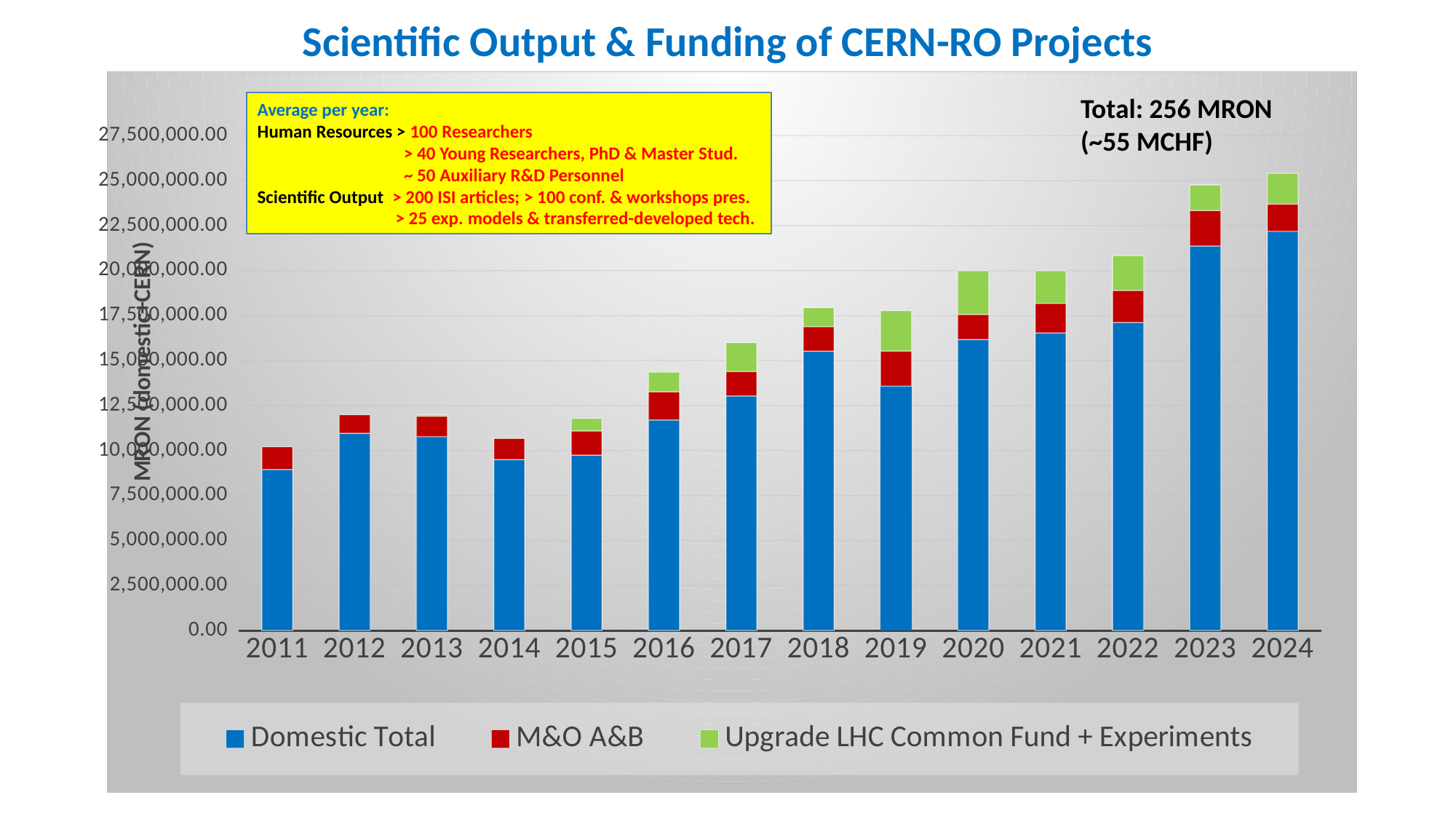
How many series does the chart legend list? 3 Which year has the tallest stacked bar overall? 2024 Is the Domestic Total value for 2011 greater or less than 10,000,000.00? less In which year does the Upgrade LHC Common Fund + Experiments segment first appear? 2013 Which year has the taller stacked bar, 2012 or 2014? 2012 What kind of chart is shown on the slide? Stacked bar chart Which series is shown in blue in the chart? Domestic Total Is the Domestic Total value for 2023 greater or less than 20,000,000.00? greater Do the total bar heights generally rise or fall from 2011 to 2024? Rise How many years are shown on the x axis of the chart? 14 What is the title of the chart? Scientific Output & Funding of CERN-RO Projects Is the total stacked bar for 2017 greater or less than 15,000,000.00? greater